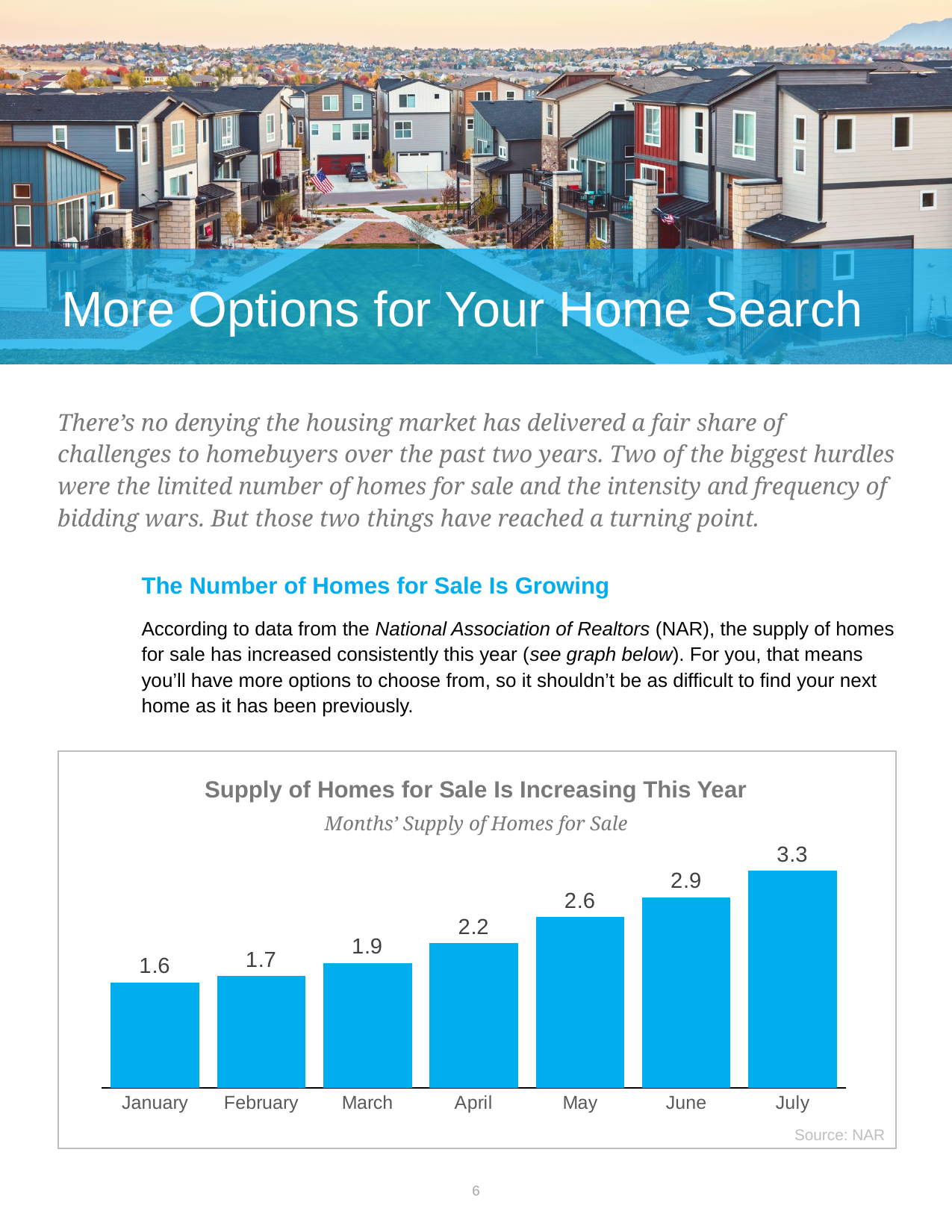
Which month has the highest months' supply of homes for sale? July What is the difference between the months' supply in May and in March? 0.7 What is the months' supply of homes for sale in April? 2.2 What kind of chart is shown on the slide? Bar chart How many months are shown on the chart? 7 What is the difference between the months' supply in July and in January? 1.7 Which month has the lowest months' supply of homes for sale? January What is the title of the chart? Supply of Homes for Sale Is Increasing This Year Do the values rise or fall from January to July? Rise Which month has a larger months' supply of homes for sale, February or June? June What is the months' supply of homes for sale in June? 2.9 What is the months' supply of homes for sale in January? 1.6